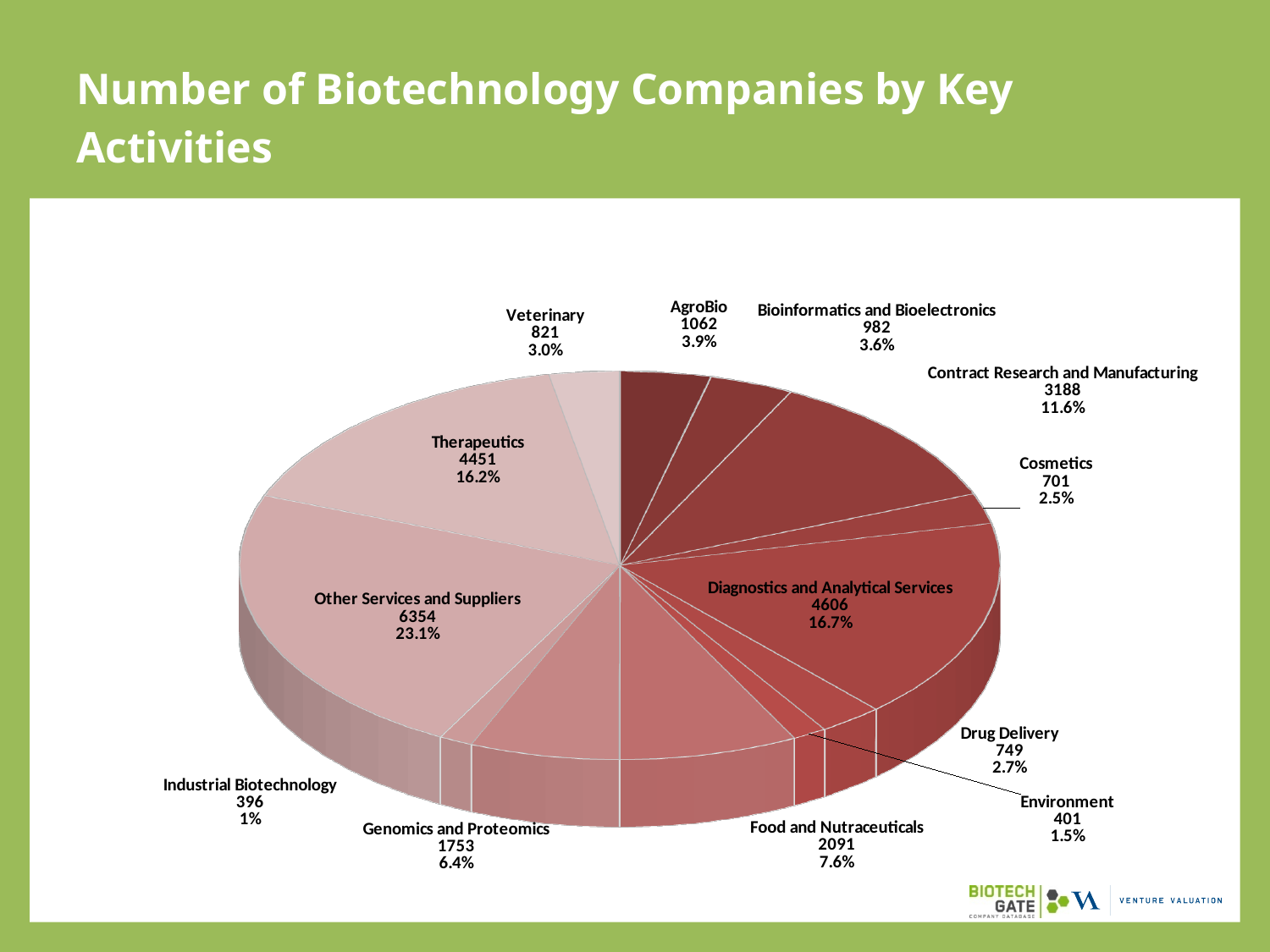
How many categories does the pie chart show? 13 What is the difference in the number of companies between Other Services and Suppliers and Therapeutics? 1903 What share of the pie does Diagnostics and Analytical Services represent? 16.7% What kind of chart is shown on the slide? Pie chart What is the number of companies for Therapeutics? 4451 Which category has the highest number of companies? Other Services and Suppliers Which category has the lowest number of companies? Industrial Biotechnology Which has more companies, Cosmetics or Drug Delivery? Drug Delivery What is the title of the slide? Number of Biotechnology Companies by Key Activities What is the number of companies for Food and Nutraceuticals? 2091 What share of the pie does Genomics and Proteomics represent? 6.4% What is the number of companies for Contract Research and Manufacturing? 3188